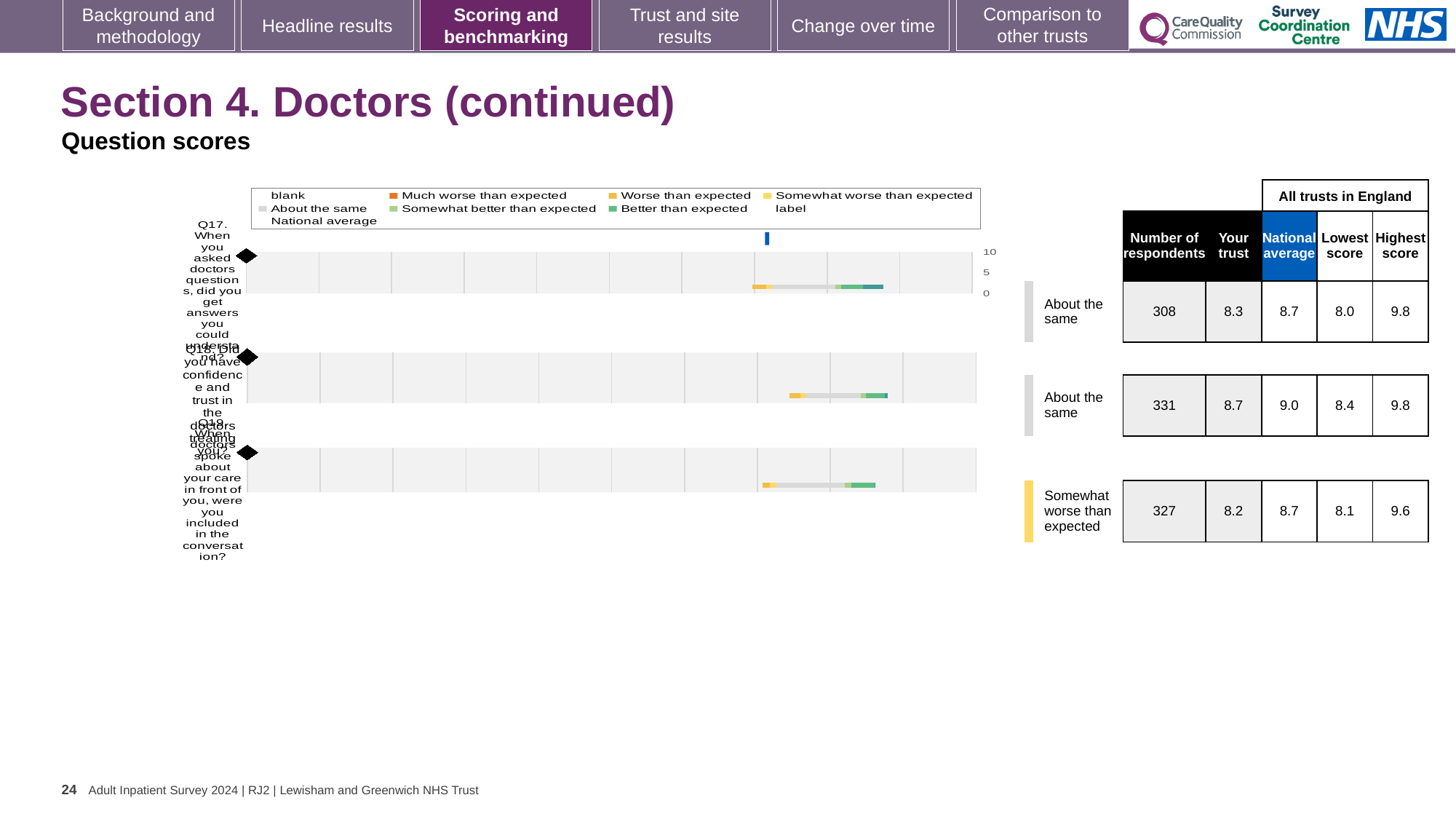
What kind of chart is used to show the question scores on this slide? bar chart What is the highest value shown on the chart's axis? 10 Which of the three questions has the highest 'Your trust' score in the table beside the chart? Q18 Is the 'Your trust' score for Q17 or for Q18 larger in the table beside the chart? Q18 Which of the three questions has the lowest 'Your trust' score in the table beside the chart? Q19 How many questions (categories) are plotted in the chart on this slide? 3 What benchmark category is given for Q19 next to the chart? Somewhat worse than expected According to the table beside the chart, what is the national average for Q18 (confidence and trust in doctors)? 9.0 According to the table beside the chart, what is the 'Your trust' score for Q17 (answers you could understand)? 8.3 What is the difference between the national average and the 'Your trust' score for Q19 in the table beside the chart? 0.5 Which legend entry in the chart is shown in orange-red? Much worse than expected According to the table beside the chart, how many respondents answered Q19 (included in the conversation)? 327